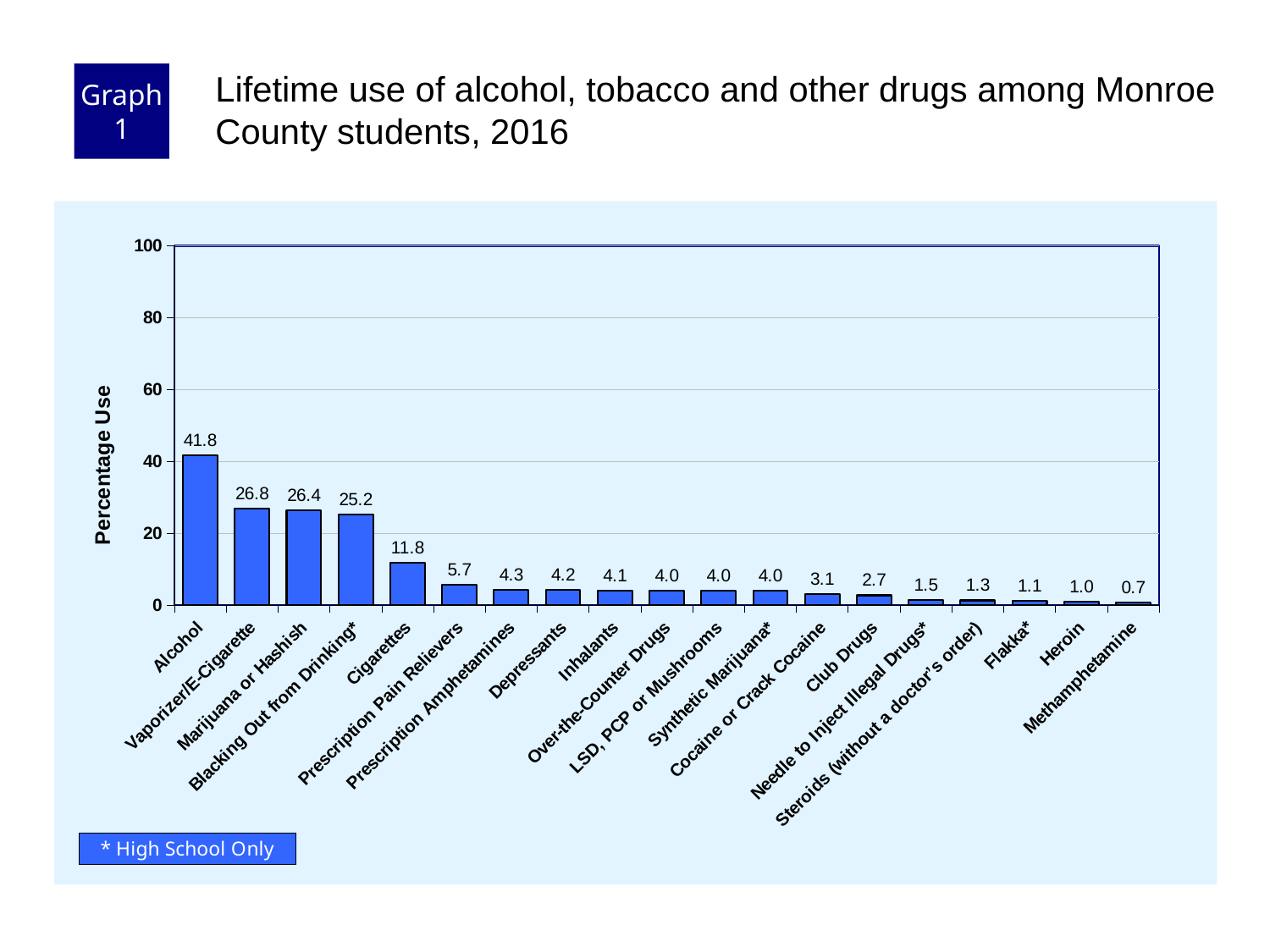
Which category has the highest percentage use? Alcohol What is the percentage use value for Cigarettes? 11.8 Which category has the lowest percentage use? Methamphetamine Which is larger, the value for Cigarettes or the value for Prescription Pain Relievers? Cigarettes How many categories are shown on the x axis? 19 Is the value for Alcohol greater or less than 40? greater What is the label of the y axis? Percentage Use What is the difference between the values for Alcohol and Vaporizer/E-Cigarette? 15.0 What kind of chart is shown on the slide? Bar chart What is the percentage use value for Alcohol? 41.8 Do the values rise or fall moving from left to right along the x axis? Fall What is the percentage use value for Heroin? 1.0